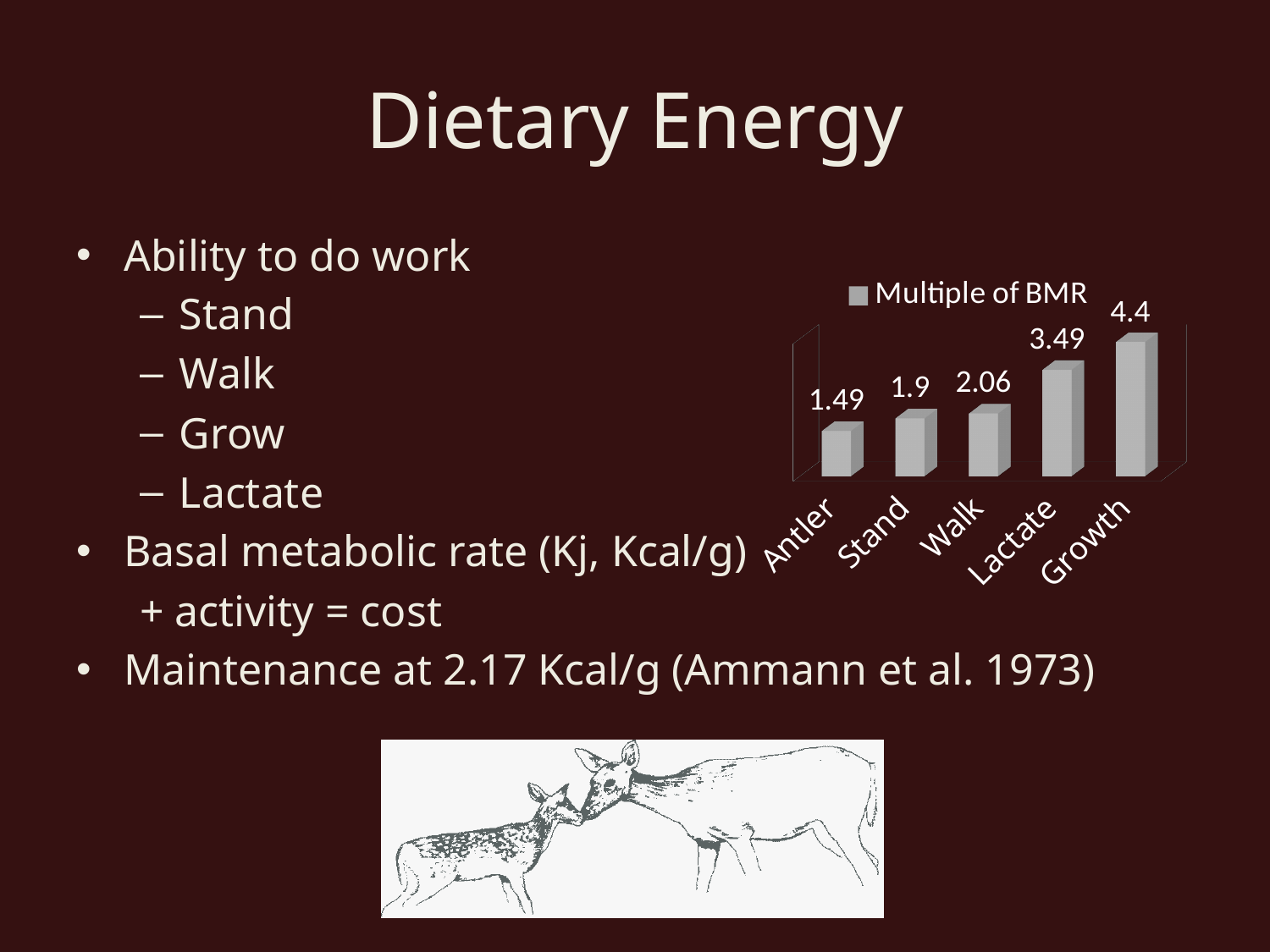
What kind of chart is shown on the slide? Bar chart What is the Multiple of BMR value for Walk? 2.06 Which category has the highest Multiple of BMR? Growth Do the values rise or fall from Antler to Growth along the x axis? Rise What is the Multiple of BMR value for Stand? 1.9 What is the Multiple of BMR value for Antler? 1.49 How many categories are shown in the chart? 5 Which has a larger Multiple of BMR, Walk or Lactate? Lactate How many series does the chart legend list? 1 What is the Multiple of BMR value for Lactate? 3.49 Which category has the lowest Multiple of BMR? Antler What is the difference between the Multiple of BMR for Growth and for Lactate? 0.91